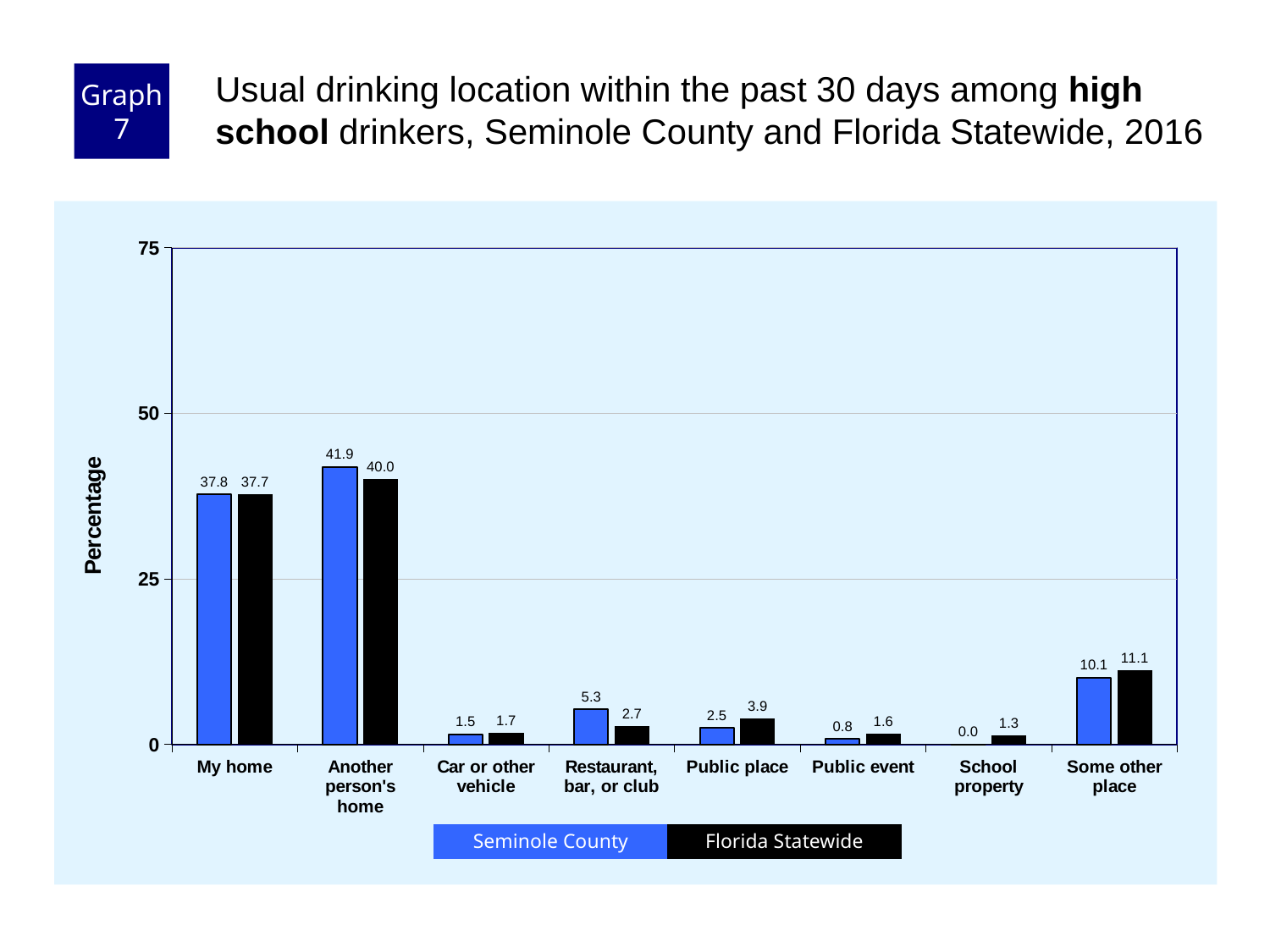
What is the Seminole County value for "Another person's home"? 41.9 What is the label of the y axis? Percentage How many categories are shown on the x axis? 8 What is the difference between the Seminole County and Florida Statewide values for "Restaurant, bar, or club"? 2.6 Which category has the lowest Florida Statewide value? School property Which category has the highest Seminole County value? Another person's home What is the Seminole County value for "School property"? 0.0 How many series does the legend list? 2 For "Public place", which is larger: the Seminole County value or the Florida Statewide value? Florida Statewide What is the Florida Statewide value for "Some other place"? 11.1 What kind of chart is shown on the slide? bar chart Is the Florida Statewide value for "Another person's home" greater or less than 50? less